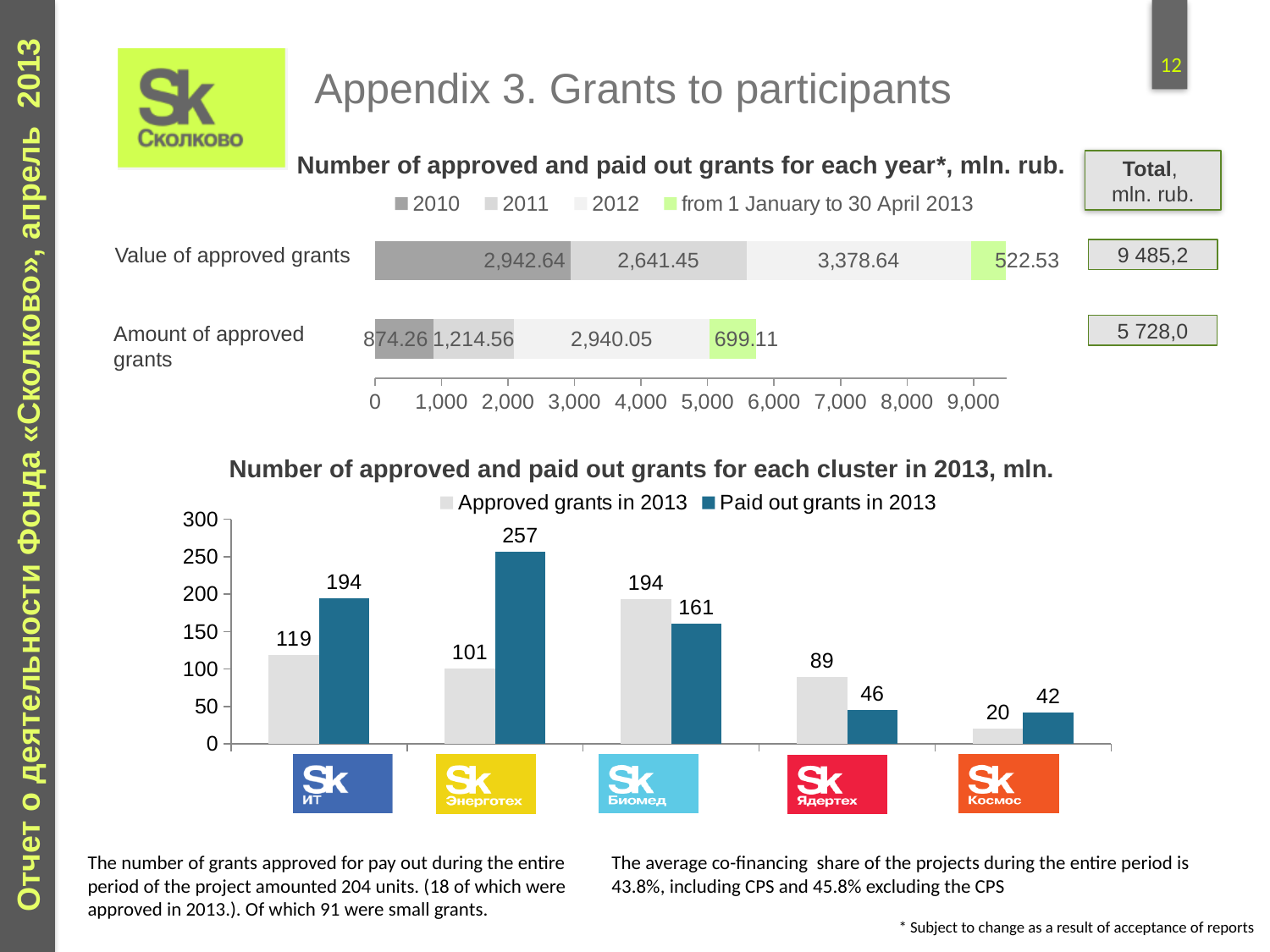
How many series does the legend list in the chart 'Number of approved and paid out grants for each cluster in 2013, mln.'? 2 In the chart 'Number of approved and paid out grants for each cluster in 2013, mln.', which cluster has the highest value of paid out grants in 2013? Энерготех In the chart 'Number of approved and paid out grants for each cluster in 2013, mln.', what is the value of approved grants in 2013 for the Биомед cluster? 194 In the chart 'Number of approved and paid out grants for each cluster in 2013, mln.', which is larger for the Ядертех cluster: approved grants in 2013 or paid out grants in 2013? Approved grants in 2013 How many series does the legend list in the chart 'Number of approved and paid out grants for each year*, mln. rub.'? 4 How many clusters are shown in the chart 'Number of approved and paid out grants for each cluster in 2013, mln.'? 5 In the chart 'Number of approved and paid out grants for each cluster in 2013, mln.', what is the difference between paid out grants and approved grants in 2013 for the ИТ cluster? 75 In the chart 'Number of approved and paid out grants for each cluster in 2013, mln.', which cluster has the lowest value of approved grants in 2013? Космос In the chart 'Number of approved and paid out grants for each cluster in 2013, mln.', what is the value of paid out grants in 2013 for the Энерготех cluster? 257 What kind of chart is 'Number of approved and paid out grants for each year*, mln. rub.'? Stacked bar chart In the chart 'Number of approved and paid out grants for each year*, mln. rub.', what is the 2010 value for 'Amount of approved grants'? 874.26 In the chart 'Number of approved and paid out grants for each year*, mln. rub.', what is the 2012 value for 'Value of approved grants'? 3,378.64